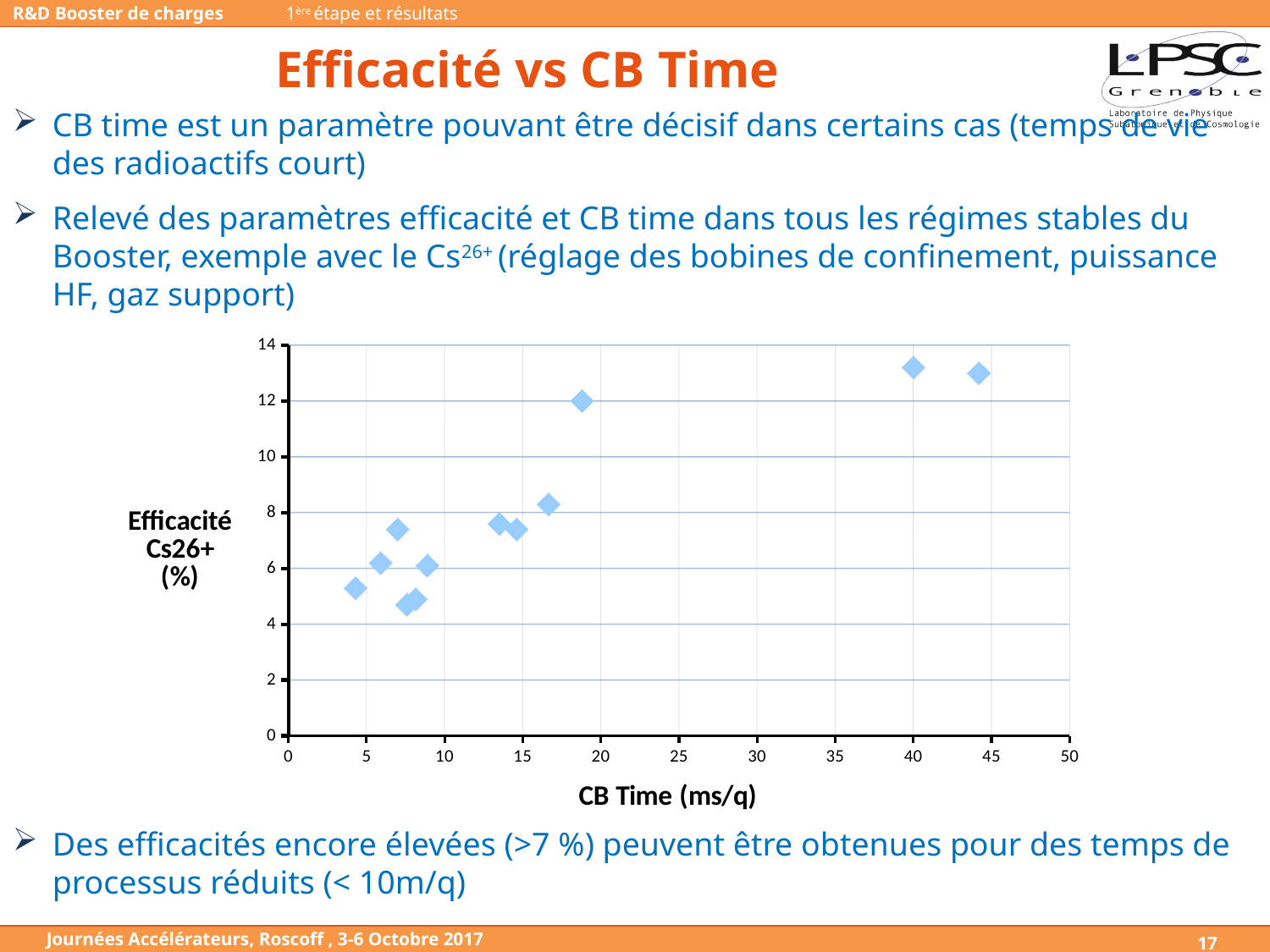
How many data points have a CB Time less than 10 ms/q? 6 Is the efficiency of the point at a CB Time of about 40 ms/q greater or less than 12? greater Is the efficiency of the point at a CB Time of about 19 ms/q greater or less than 10? greater What kind of chart is shown on the slide? scatter chart What is the label on the chart's y axis? Efficacité Cs26+ (%) What is the title of the chart's x axis? CB Time (ms/q) Which has the higher efficiency: the point at a CB Time of about 19 ms/q or the point at about 16.5 ms/q? the point at about 19 ms/q Overall, does efficiency rise or fall as CB Time increases along the x axis? rise Is the efficiency of the point with the smallest CB Time (about 4 ms/q) greater or less than 6? less How many data points are plotted on the chart? 12 What is the maximum value shown on the x axis of the chart? 50 How many data points have a CB Time greater than 30 ms/q? 2